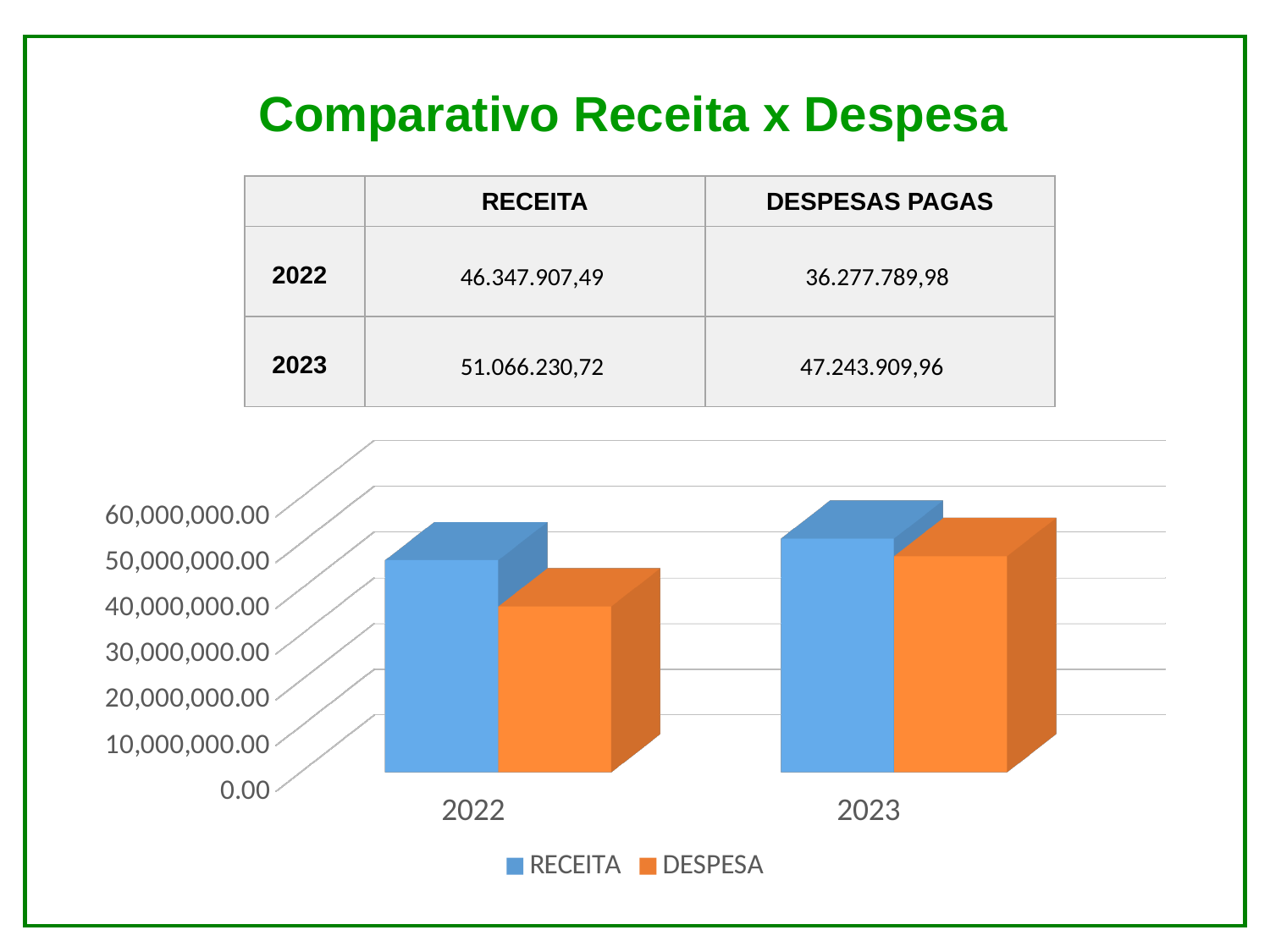
Does RECEITA rise or fall from 2022 to 2023? rise In 2022, which is larger, RECEITA or DESPESA? RECEITA According to the table, what is the RECEITA value for 2023? 51.066.230,72 Which year has the higher RECEITA? 2023 How many series does the chart legend list? 2 How many year categories are shown on the x axis of the chart? 2 What type of chart is shown on the slide? bar chart According to the table, what is the DESPESAS PAGAS value for 2023? 47.243.909,96 Is the DESPESA bar for 2022 greater or less than 40,000,000.00? less According to the table, what is the RECEITA value for 2022? 46.347.907,49 Using the table values, what is the difference between RECEITA and DESPESAS PAGAS in 2022? 10.070.117,51 Which year has the lower DESPESA? 2022